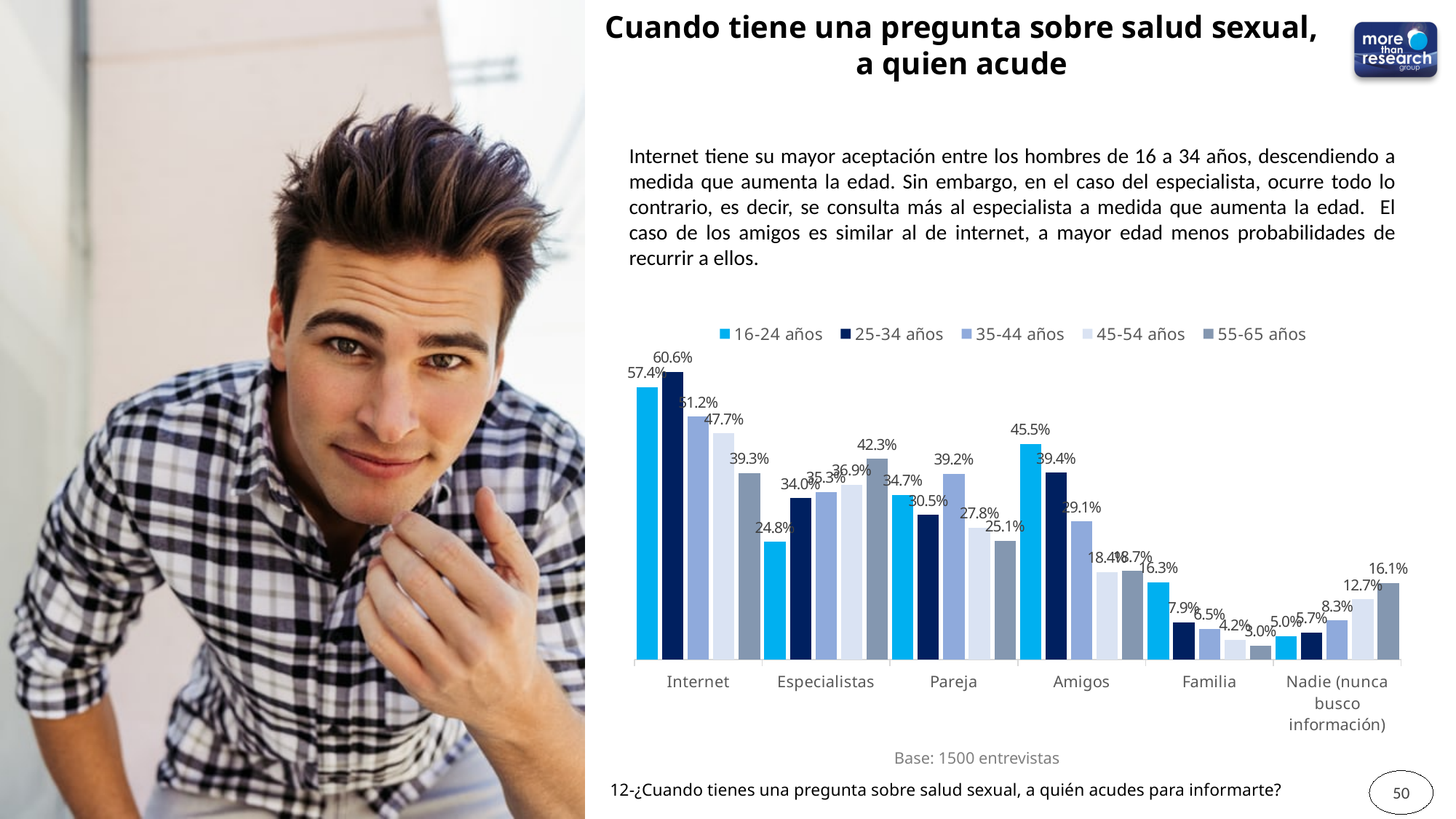
What is the value for the 55-65 años series in the Familia category? 3.0% What kind of chart is shown on the slide? Bar chart What is the difference between the 25-34 años and 16-24 años values in the Internet category? 3.2 percentage points What is the value for the 55-65 años series in the Especialistas category? 42.3% Which category has the highest value for the 16-24 años series? Internet How many categories are shown on the x axis of the chart? 6 How many series does the chart legend list? 5 Which category has the lowest value for the 55-65 años series? Familia What is the value for the 16-24 años series in the Amigos category? 45.5% What is the value for the 25-34 años series in the Internet category? 60.6% In the Nadie (nunca busco información) category, do the values rise or fall as the age group increases from 16-24 años to 55-65 años? Rise In the Pareja category, which is larger: the 16-24 años value or the 25-34 años value? 16-24 años